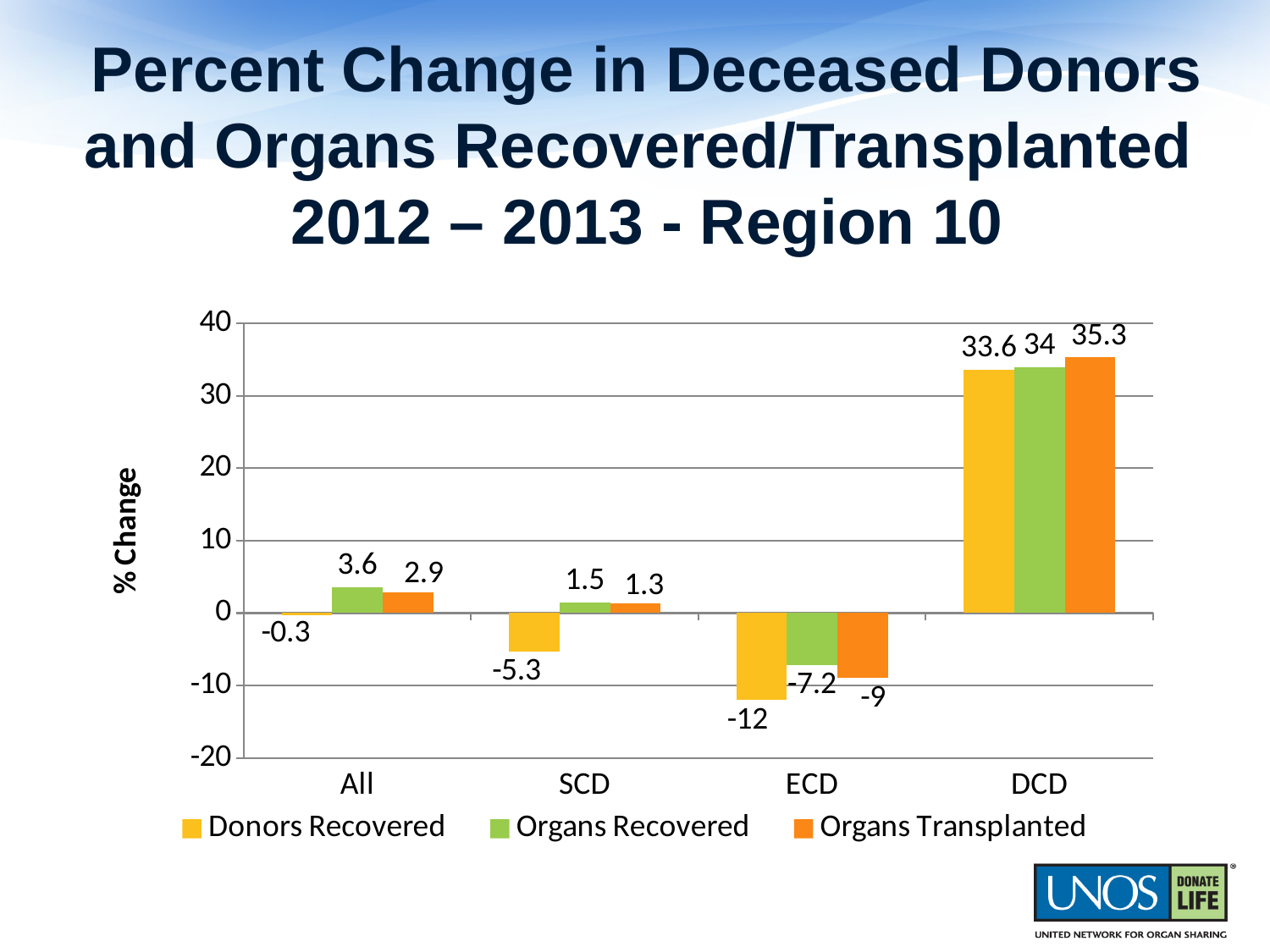
What is the value for Organs Recovered in the SCD category? 1.5 What is the value for Organs Transplanted in the DCD category? 35.3 What is the value for Donors Recovered in the ECD category? -12 Is the value for Organs Recovered in the DCD category greater or less than 30? greater Which is larger in the All category: Organs Recovered or Organs Transplanted? Organs Recovered Which category has the lowest value for Organs Transplanted? ECD What kind of chart is shown on the slide? bar chart What is the label of the y axis? % Change Which category has the highest value for Donors Recovered? DCD What is the difference between Organs Transplanted and Donors Recovered in the DCD category? 1.7 How many categories are shown on the x axis? 4 How many series does the legend list? 3